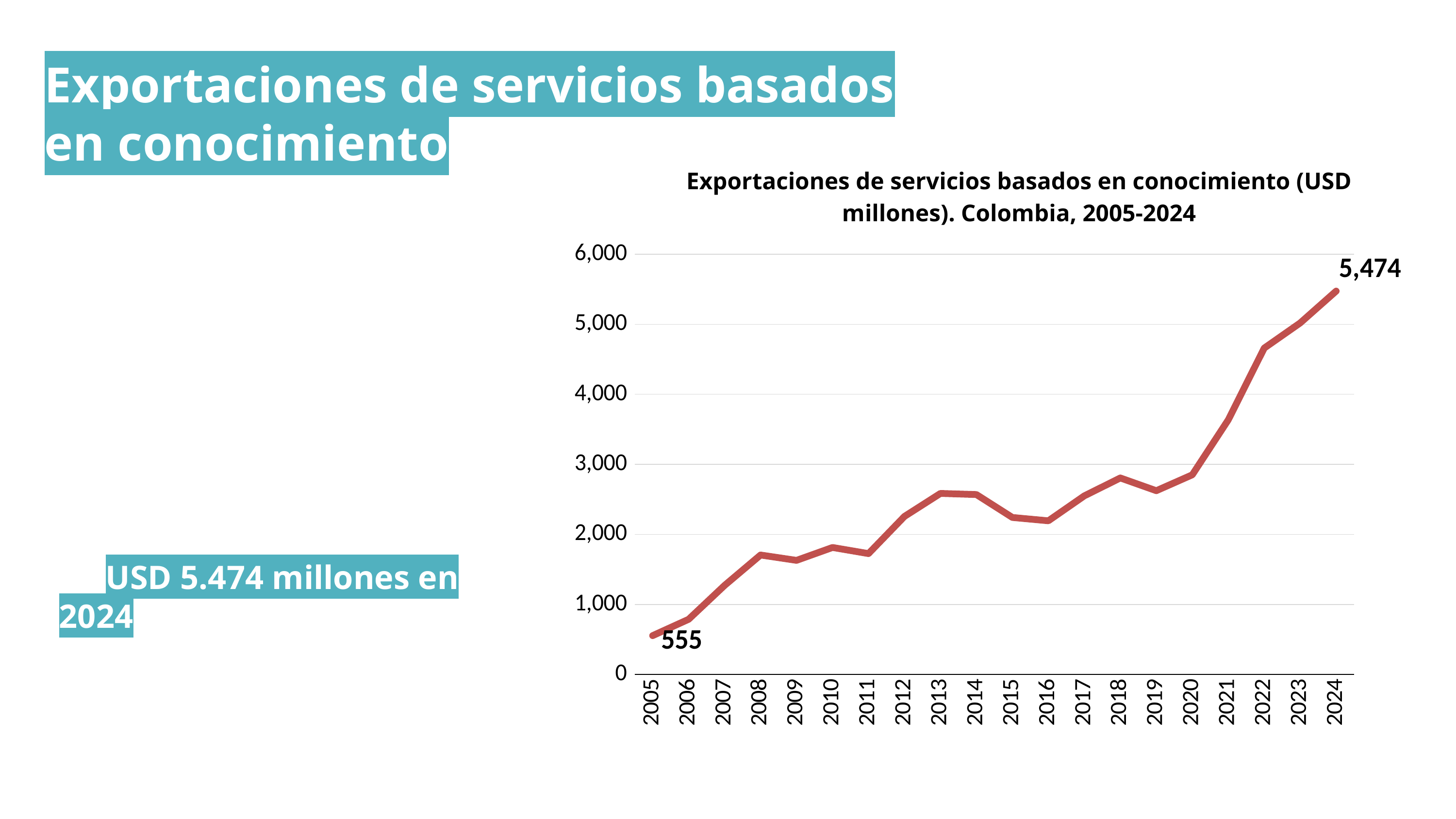
What is the value for 2024? 5,474 Which is larger, the value for 2013 or the value for 2016? 2013 Which year has the highest value? 2024 Do the values generally rise or fall from 2005 to 2024? rise What is the value for 2005? 555 What is the title of the chart? Exportaciones de servicios basados en conocimiento (USD millones). Colombia, 2005-2024 Which year has the lowest value? 2005 What is the difference between the values for 2024 and 2005? 4,919 Is the value for 2009 greater or less than 2,000? less What kind of chart is this? line chart Is the value for 2022 greater or less than 4,000? greater How many years are shown on the x axis? 20